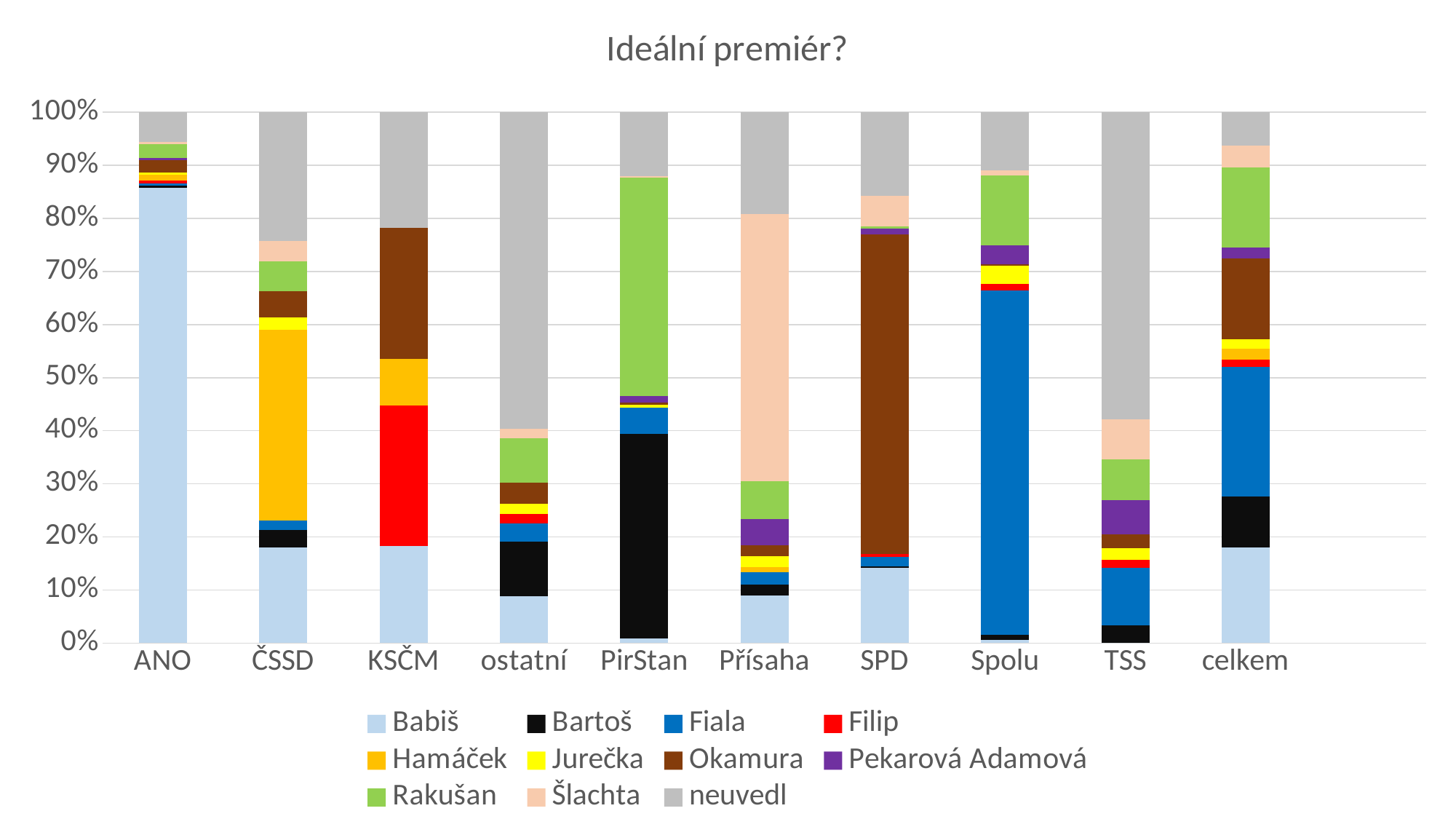
Is the Fiala segment for Spolu greater or less than 60%? greater Is the Bartoš segment for PirStan greater or less than 30%? greater Which category has the largest Babiš segment? ANO Which category has the largest Rakušan segment? PirStan How many series does the legend list? 11 Which series is shown in light blue in the legend? Babiš How many categories are shown on the x axis? 10 What is the title of the chart? Ideální premiér? Is the Babiš segment for ANO greater or less than 80%? greater What kind of chart is shown on the slide? stacked bar chart